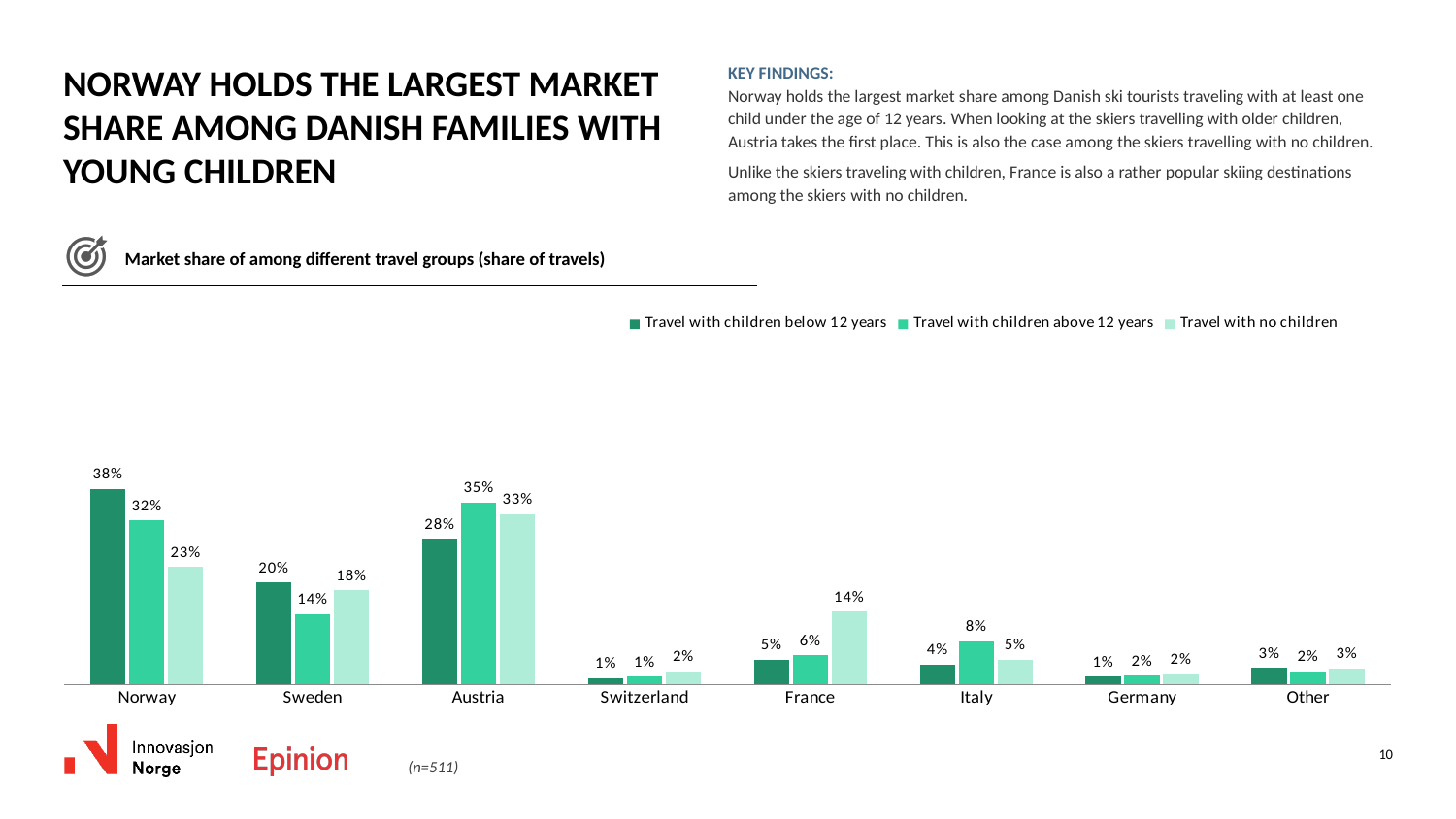
How many destination categories are shown on the x axis? 8 What is the market share for Norway among those who travel with children below 12 years? 38% What is the market share for France among those who travel with no children? 14% What is the market share for Austria among those who travel with children above 12 years? 35% What is the title of the chart? Market share of among different travel groups (share of travels) Which is larger for Sweden: the share for travel with children above 12 years or the share for travel with no children? Travel with no children How many series does the legend list? 3 What is the difference between Norway's and Austria's market share among those who travel with children below 12 years? 10 percentage points Which destination has the highest market share among those who travel with no children? Austria What is the market share for Italy among those who travel with children above 12 years? 8% Which destination has the lowest market share among those who travel with children below 12 years? Switzerland and Germany (both 1%) What kind of chart is shown on the slide? Bar chart